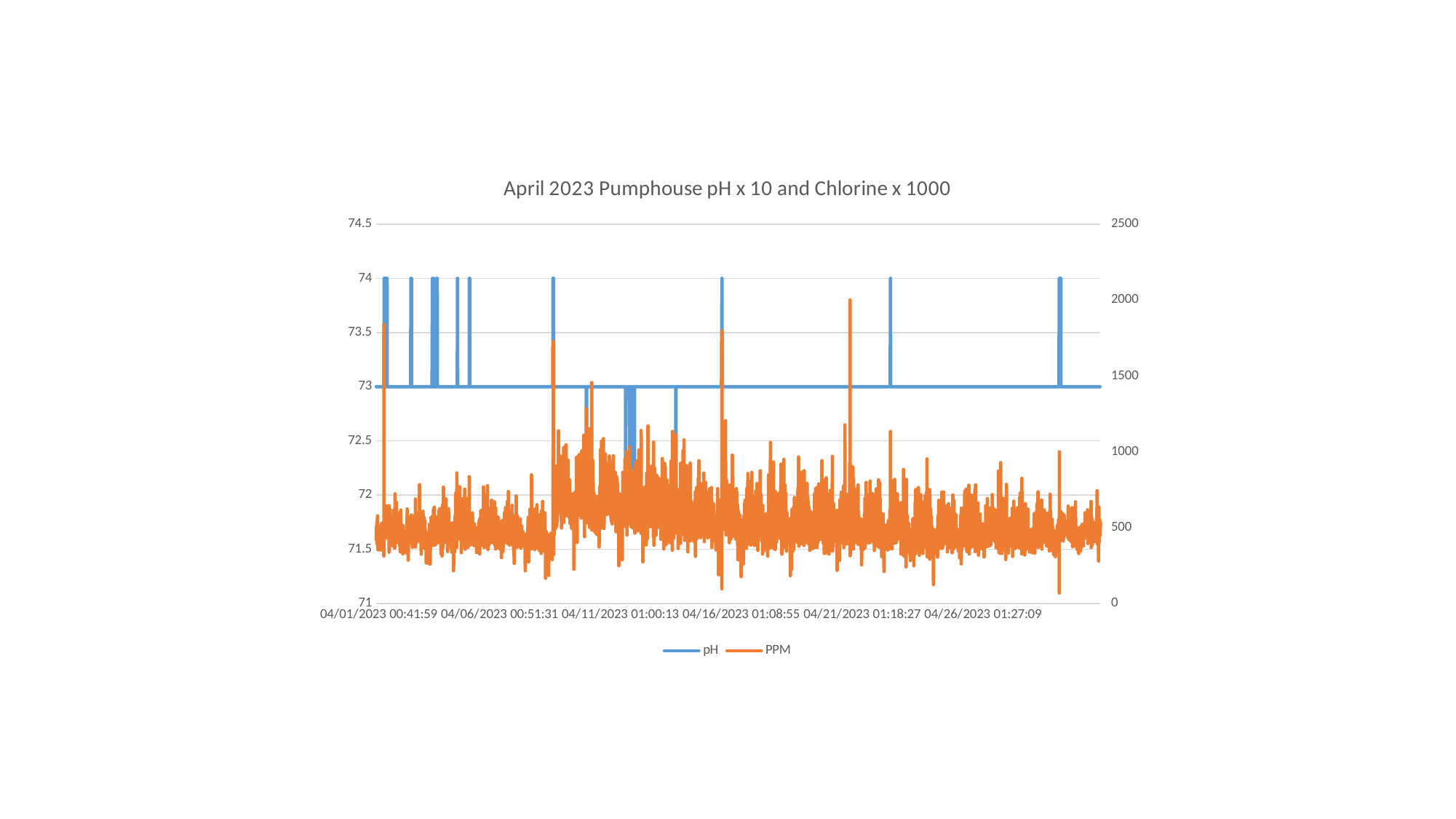
Which two series are listed in the legend? pH and PPM What is the highest value the pH line reaches? 74 What is the highest value shown on the left vertical axis? 74.5 At what level does the pH line sit for most of the month? 73 What is the first date label shown on the x axis? 04/01/2023 00:41:59 What is the title of the chart? April 2023 Pumphouse pH x 10 and Chlorine x 1000 What kind of chart is shown on the slide? line chart What is the highest value shown on the right vertical axis? 2500 How many series does the legend list? 2 Is the highest PPM spike, near 04/21/2023, greater or less than 1500? greater Is the PPM value for most of the month greater or less than 1000? less